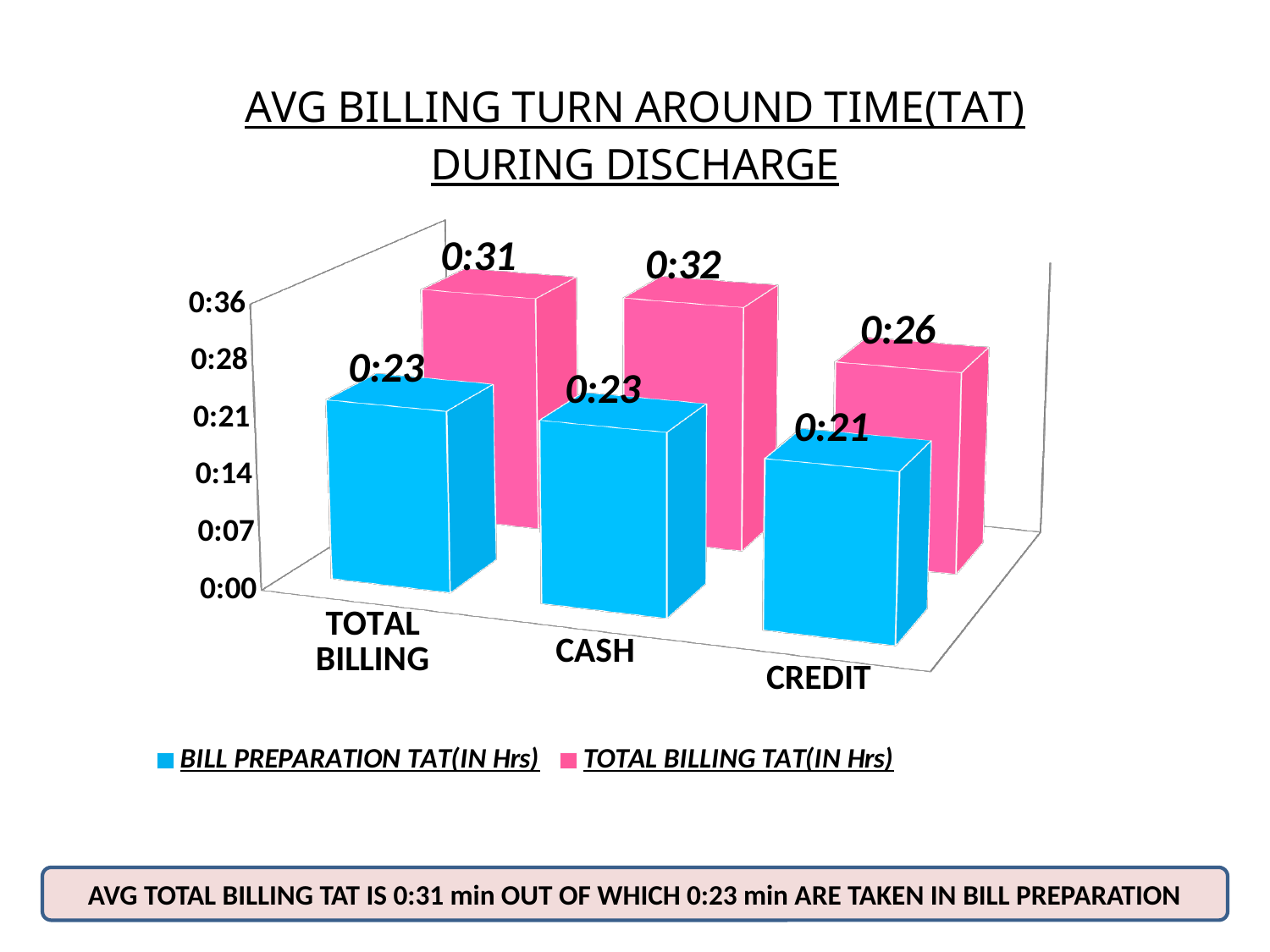
Which category has the lowest BILL PREPARATION TAT(IN Hrs)? CREDIT How many categories are shown on the x axis of the chart? 3 What kind of chart is shown on the slide? Bar chart What is the TOTAL BILLING TAT(IN Hrs) value for CREDIT? 0:26 How many series does the chart legend list? 2 What colour are the bars for the TOTAL BILLING TAT(IN Hrs) series? Pink What is the BILL PREPARATION TAT(IN Hrs) value for CREDIT? 0:21 Which category has the highest TOTAL BILLING TAT(IN Hrs)? CASH What is the TOTAL BILLING TAT(IN Hrs) value for TOTAL BILLING? 0:31 For CREDIT, which is larger: BILL PREPARATION TAT(IN Hrs) or TOTAL BILLING TAT(IN Hrs)? TOTAL BILLING TAT(IN Hrs) What is the BILL PREPARATION TAT(IN Hrs) value for CASH? 0:23 How many minutes greater is the TOTAL BILLING TAT(IN Hrs) for CASH than for CREDIT? 6